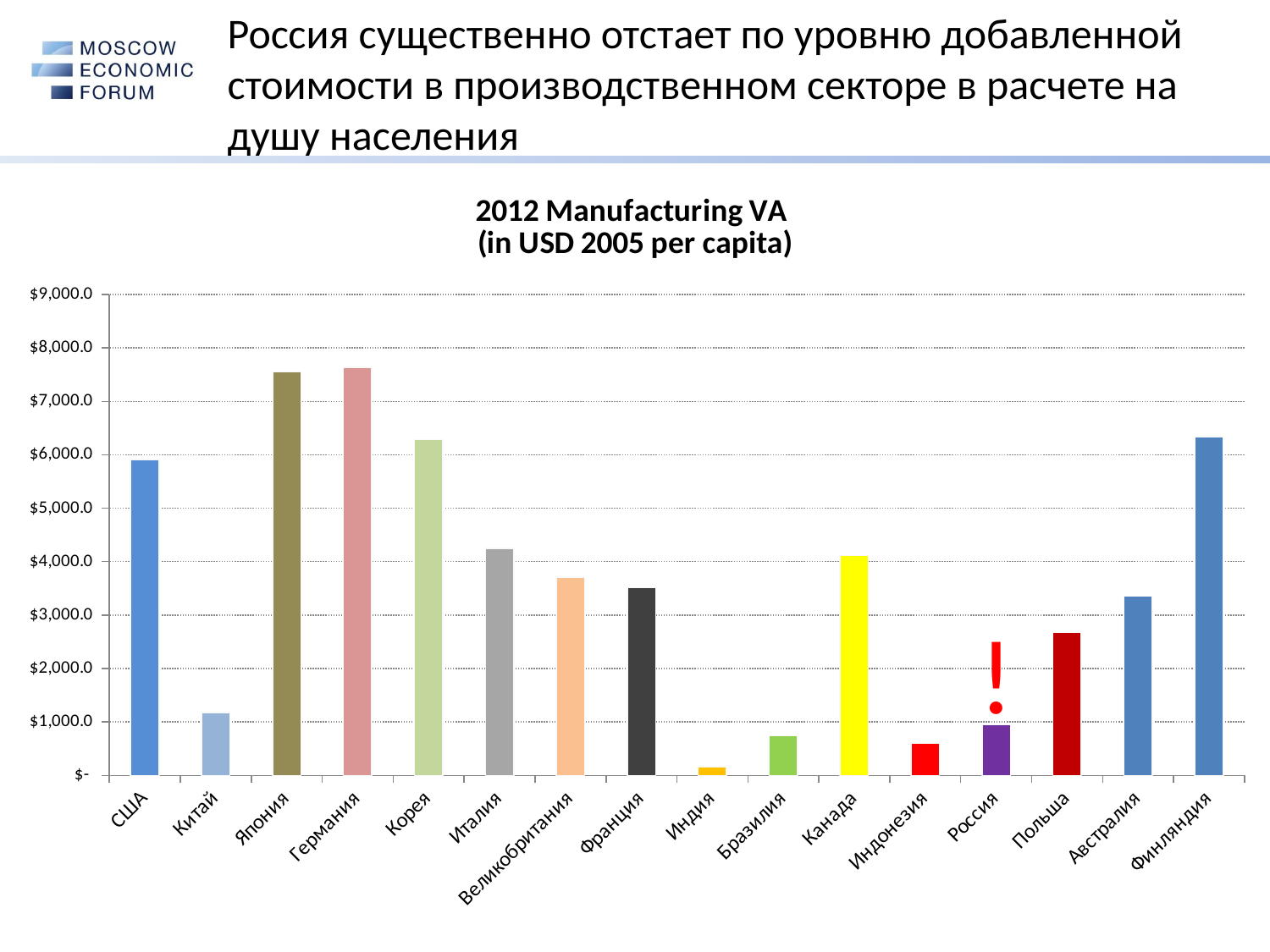
What kind of chart is shown on the slide? bar chart Which country's bar is marked with a red exclamation mark on the chart? Россия Is the value for Польша greater or less than $2,000.0? greater Is the value for США greater or less than $5,000.0? greater Which has the larger value, США or Япония? Япония Which country has the lowest manufacturing value added per capita in the chart? Индия Which has the larger value, Россия or Польша? Польша How many countries are shown on the x axis of the chart? 16 What is the title of the chart? 2012 Manufacturing VA (in USD 2005 per capita) Is the value for Индонезия greater or less than $1,000.0? less